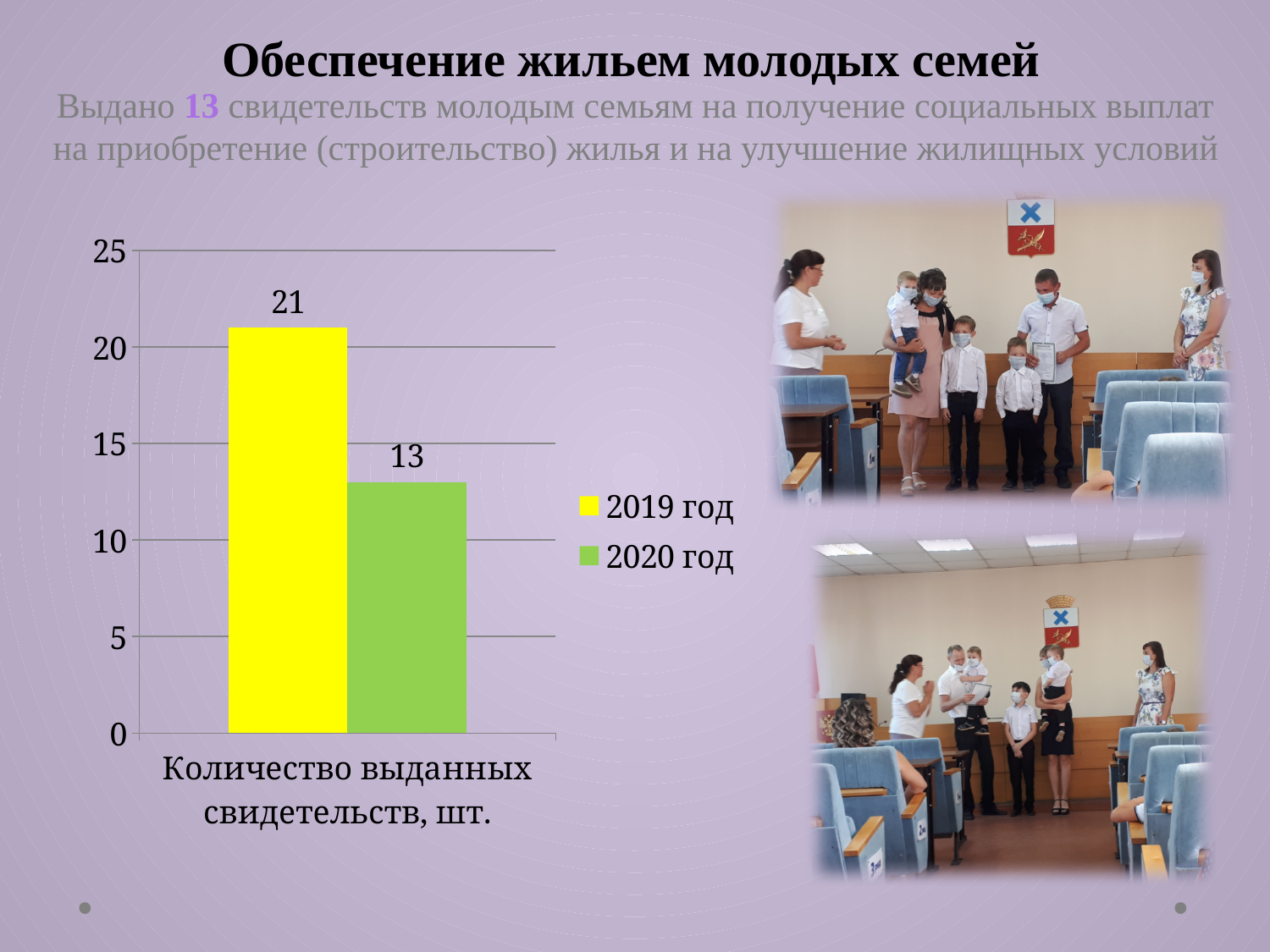
What kind of chart is shown on the slide? bar chart What is the category label on the x axis of the chart? Количество выданных свидетельств, шт. Is the value for 2019 год greater or less than the value for 2020 год? greater How many series does the legend list? 2 What is the value for 2019 год (Количество выданных свидетельств, шт.)? 21 Which series has the lower value, 2019 год or 2020 год? 2020 год Which series has the higher value, 2019 год or 2020 год? 2019 год What is the difference between the values for 2019 год and 2020 год? 8 Is the value for 2020 год greater or less than 15? less What colour is the bar for 2020 год? green Is the value for 2019 год greater or less than 20? greater What is the value for 2020 год (Количество выданных свидетельств, шт.)? 13